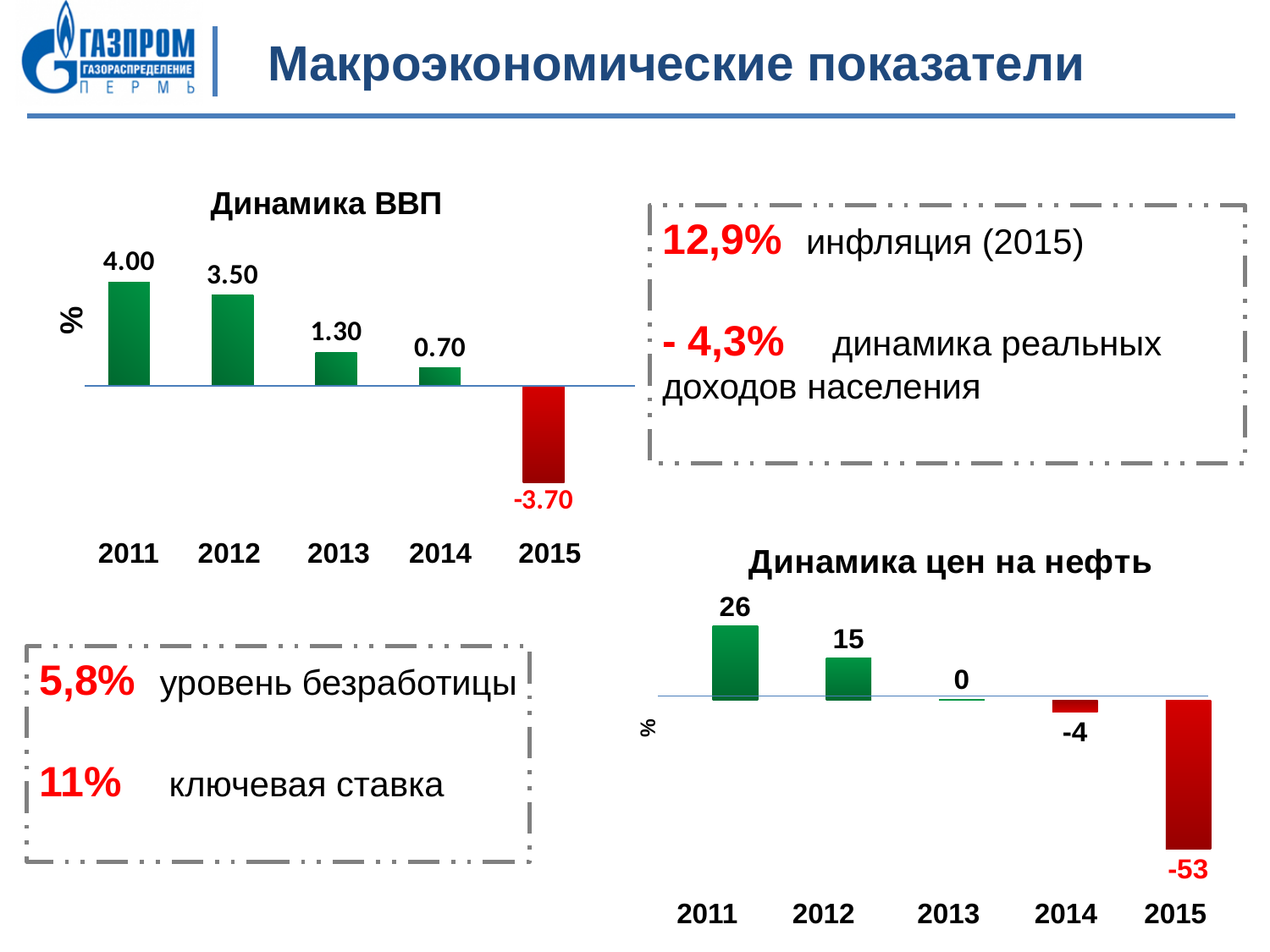
In the 'Динамика ВВП' chart, what is the value for 2015? -3.70 In the 'Динамика ВВП' chart, which year has the highest value? 2011 In the 'Динамика цен на нефть' chart, what is the value for 2015? -53 In the 'Динамика ВВП' chart, how many years are shown? 5 In the 'Динамика цен на нефть' chart, what is the value for 2012? 15 In the 'Динамика цен на нефть' chart, what is the difference between the values for 2011 and 2014? 30 What kind of chart is 'Динамика цен на нефть'? bar chart In the 'Динамика цен на нефть' chart, which year has the highest value? 2011 In the 'Динамика ВВП' chart, what is the value for 2011? 4.00 In the 'Динамика ВВП' chart, do the values rise or fall from 2011 to 2015? fall In the 'Динамика ВВП' chart, which year has the lowest value? 2015 In the 'Динамика ВВП' chart, what is the difference between the values for 2012 and 2013? 2.20